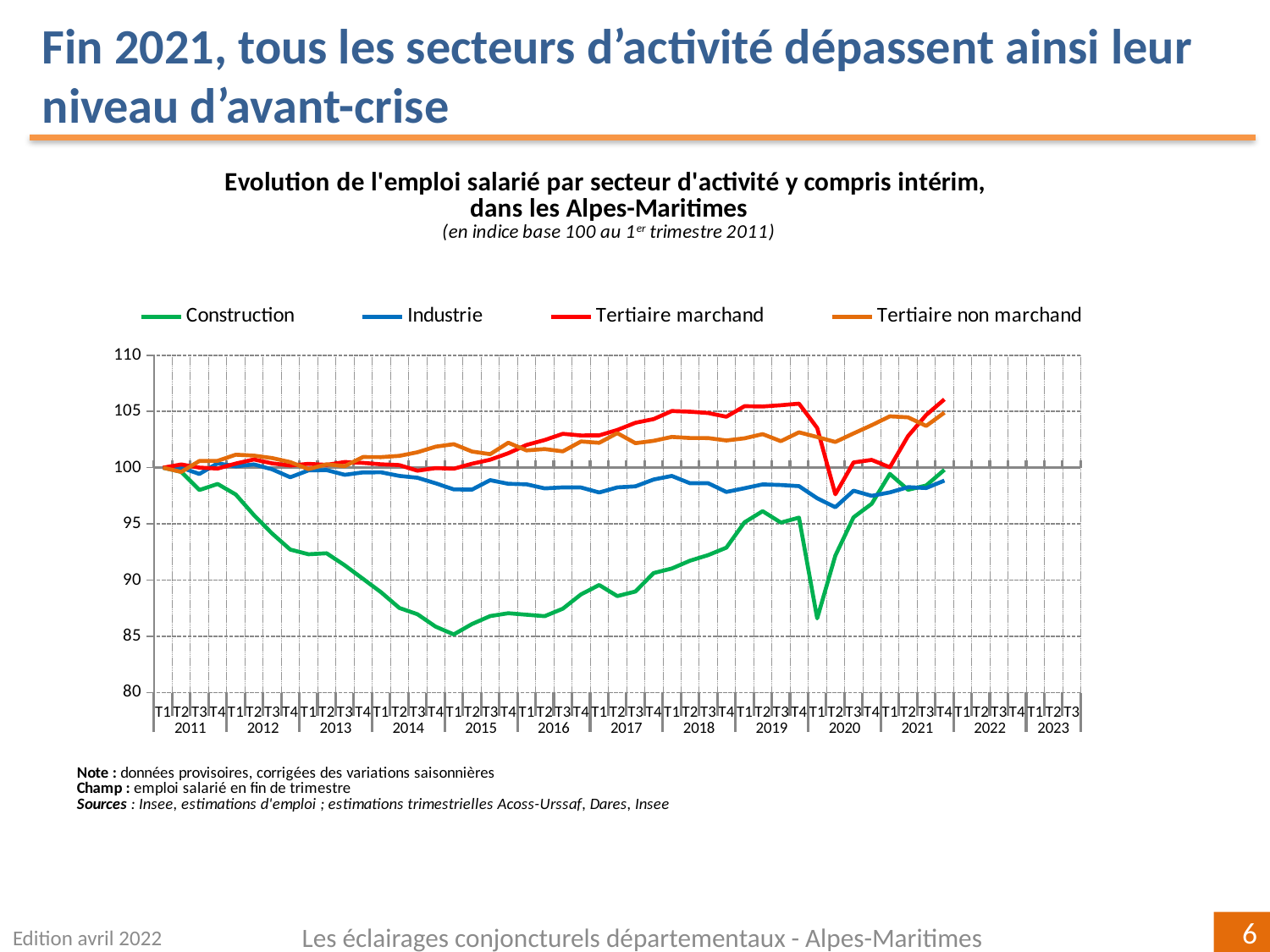
What kind of chart is shown on the slide? line chart Does the Tertiaire marchand series rise or fall between T1 2011 and T4 2019? rise Is the value for Tertiaire marchand in T1 2018 greater or less than 100? greater In T1 2020, which is higher: Tertiaire marchand or Tertiaire non marchand? Tertiaire marchand What is the base of the index used in the chart, according to the subtitle? base 100 au 1er trimestre 2011 Is the value for Industrie in T2 2020 greater or less than 100? less Which series is plotted in green? Construction Which series has the lowest value in T1 2015? Construction Does the Construction series rise or fall between T1 2011 and T1 2015? fall How many series does the legend list? 4 Is the value for Construction in T1 2015 greater or less than 90? less Which series has the highest value at the last plotted point (T4 2021)? Tertiaire marchand